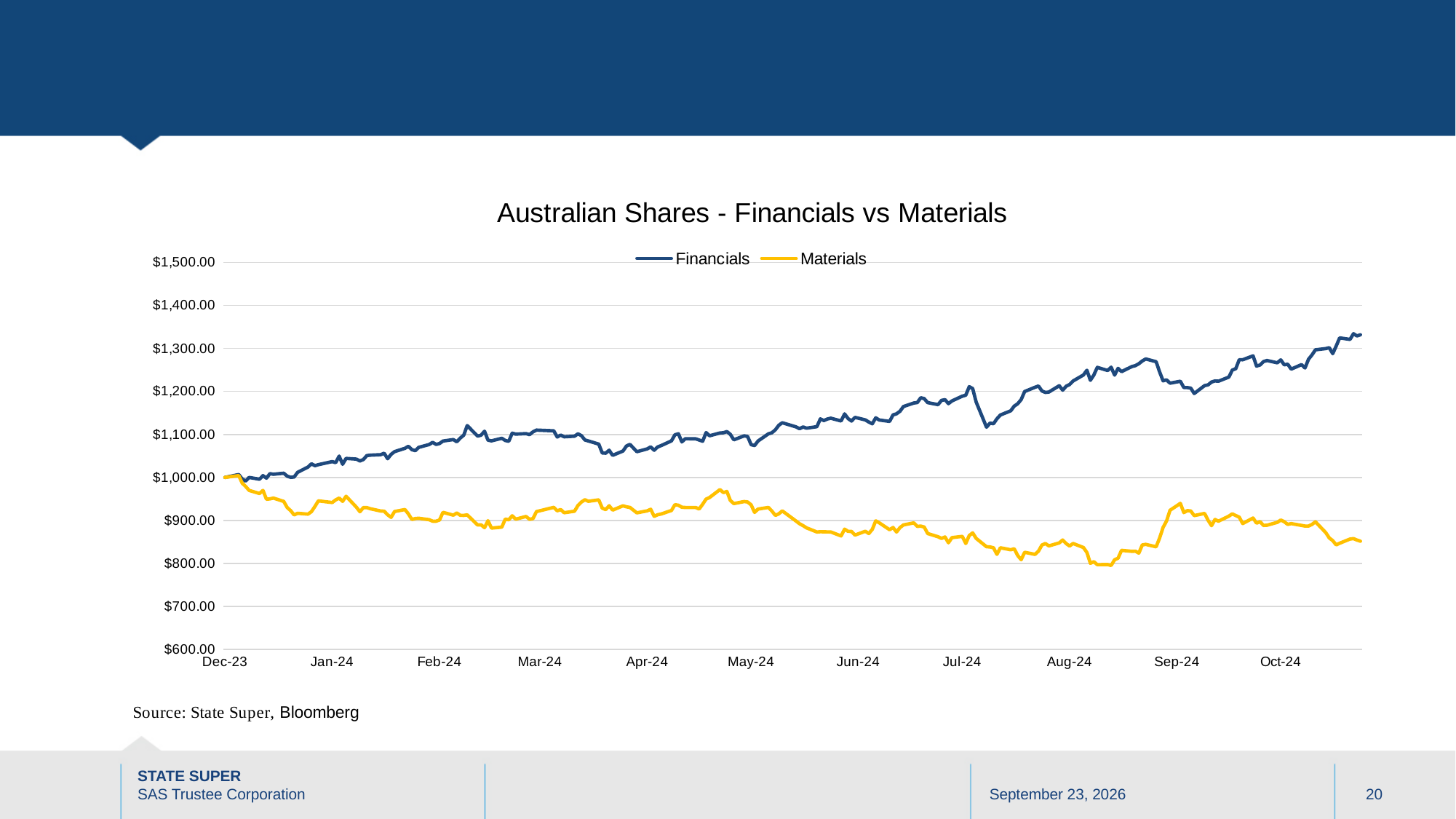
Which series reaches the highest value on the chart? Financials How many month labels are shown on the x axis? 11 Is the value for Financials at Oct-24 greater or less than $1,200.00? greater Is the value for Materials at Aug-24 greater or less than $900.00? less What kind of chart is shown on the slide? line chart Does the Financials series generally rise or fall from Dec-23 to the end of the chart? rise At Oct-24, which series has the larger value, Financials or Materials? Financials Does the Materials series generally rise or fall from Dec-23 to the end of the chart? fall What is the value of the Financials series at Dec-23? $1,000.00 What is the title of the chart? Australian Shares - Financials vs Materials Which series is drawn in yellow? Materials How many series does the legend list? 2